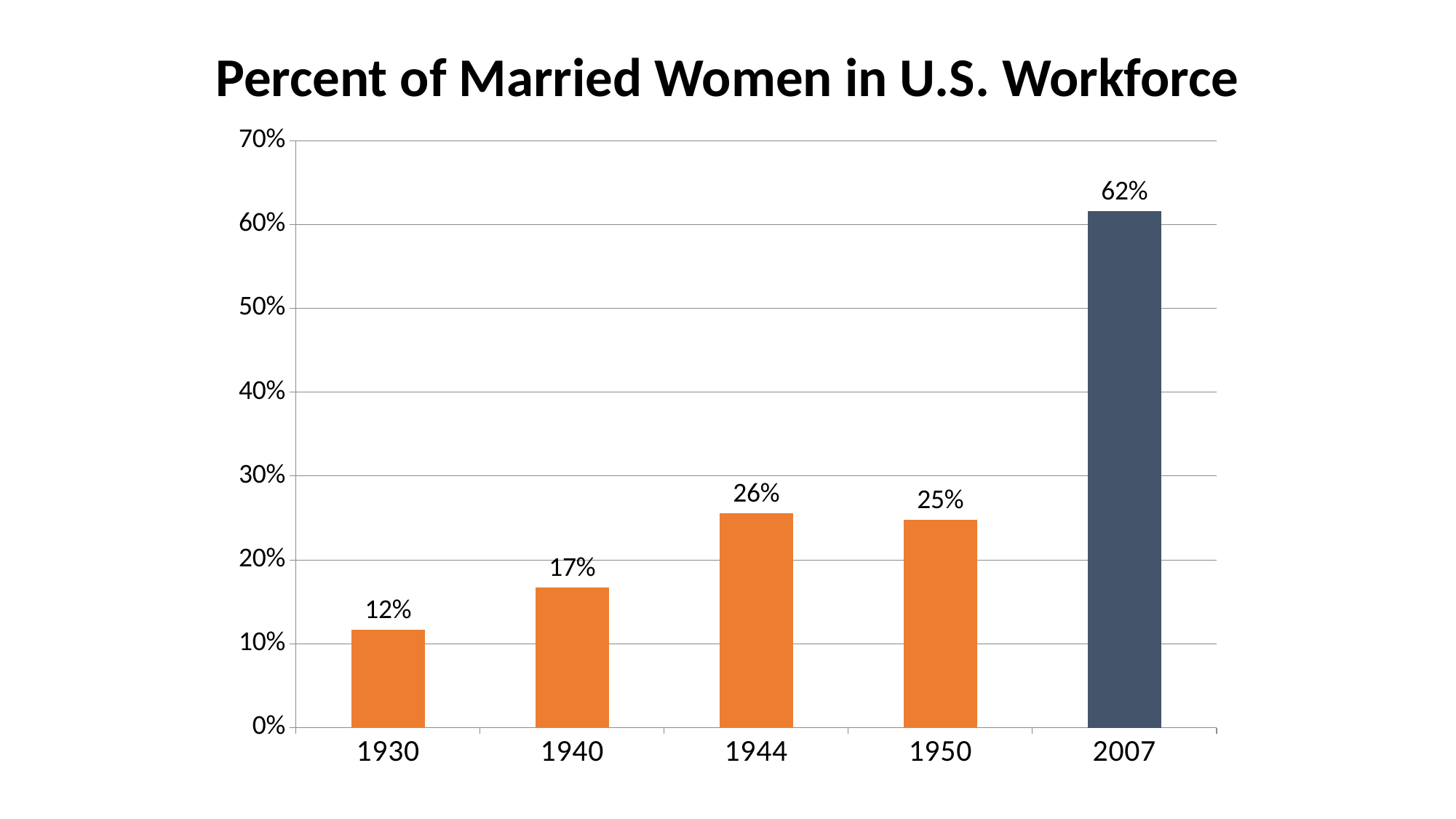
Which year has the lowest percent of married women in the U.S. workforce? 1930 Which year has a larger value, 1944 or 1950? 1944 What is the percent of married women in the U.S. workforce in 1930? 12% What is the difference between the 1940 value and the 1930 value? 5% How many years are shown on the x axis? 5 What is the title of the chart? Percent of Married Women in U.S. Workforce What kind of chart is shown on the slide? bar chart Which year has the highest percent of married women in the U.S. workforce? 2007 What is the difference between the 2007 value and the 1950 value? 37% Is the value for 1940 greater or less than 20%? less What is the percent of married women in the U.S. workforce in 1944? 26% What is the percent of married women in the U.S. workforce in 2007? 62%